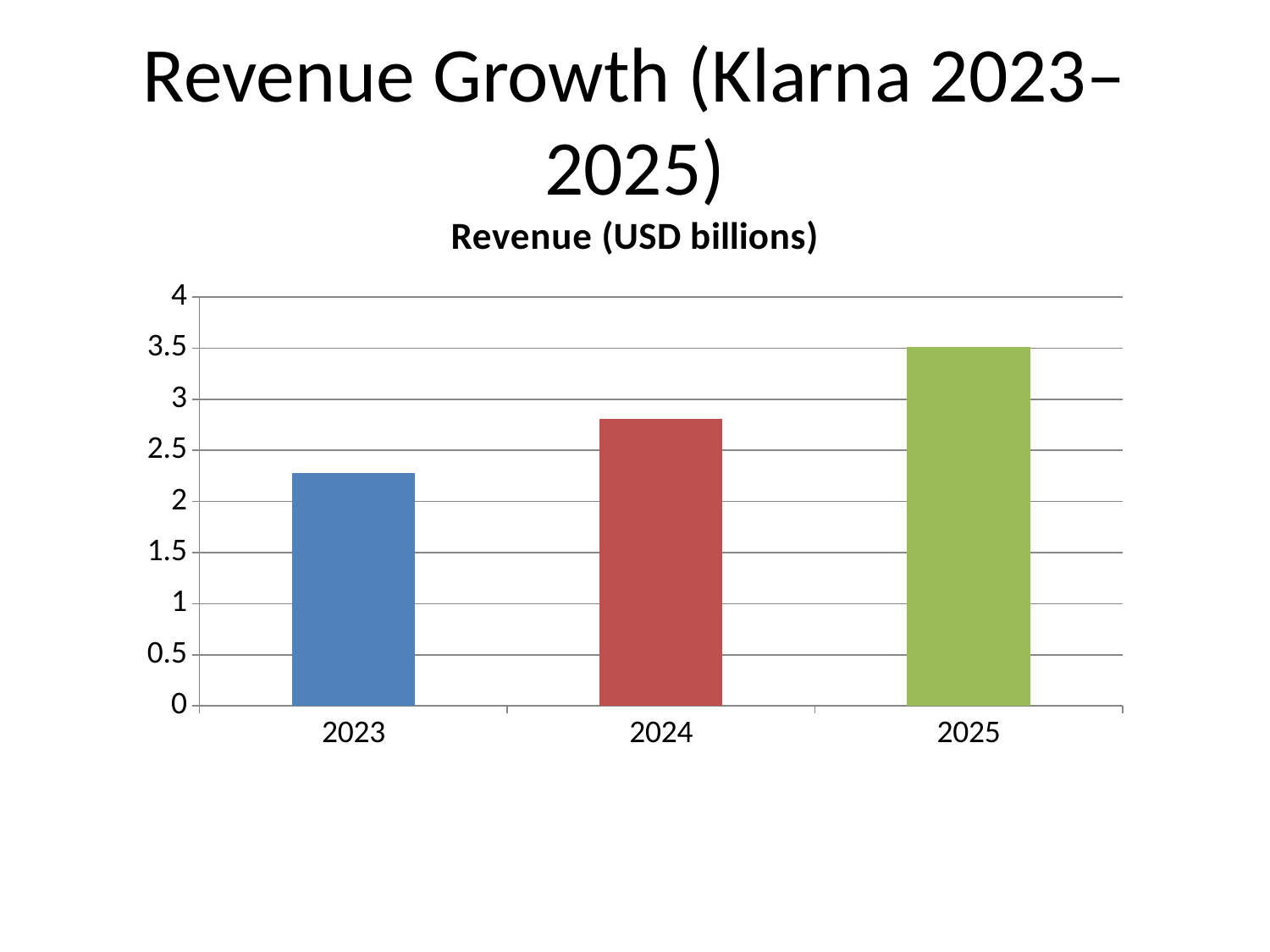
Is the value for 2023 greater or less than 2.5? less Is the value for 2024 greater or less than 2.5? greater Which year has the highest revenue? 2025 Which year has the lowest revenue? 2023 Which is larger, the revenue for 2024 or for 2023? 2024 Is the value for 2025 greater or less than 3? greater How many years are plotted on the chart? 3 Do the revenue values rise or fall from 2023 to 2025? Rise What is the title shown above the chart's plot area? Revenue (USD billions) What kind of chart is shown on the slide? Bar chart